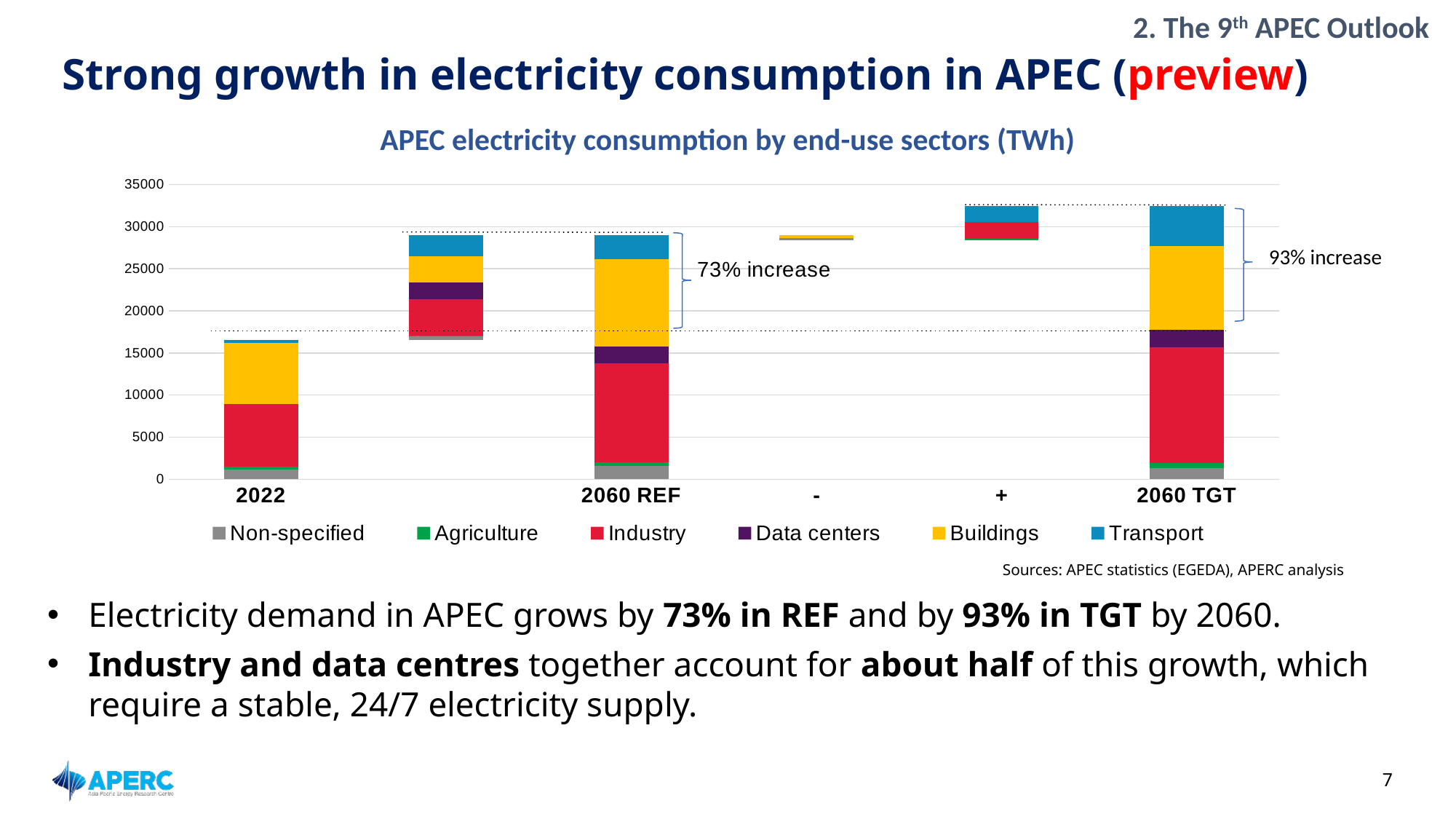
How many series does the legend list? 6 What percentage increase is annotated next to the 2060 TGT bar? 93% increase Which of the labeled scenario bars (2022, 2060 REF, 2060 TGT) has the lowest total? 2022 Which series is shown in yellow in the chart? Buildings What is the title of the chart? APEC electricity consumption by end-use sectors (TWh) Is the total value for 2060 TGT greater or less than 30000? greater Which has the larger total, 2060 REF or 2060 TGT? 2060 TGT Is the total value for 2022 greater or less than 20000? less Which of the labeled scenario bars (2022, 2060 REF, 2060 TGT) has the highest total? 2060 TGT Is the total value for 2060 REF greater or less than 25000? greater What percentage increase is annotated next to the 2060 REF bar? 73% increase What kind of chart is shown on the slide? Stacked bar chart